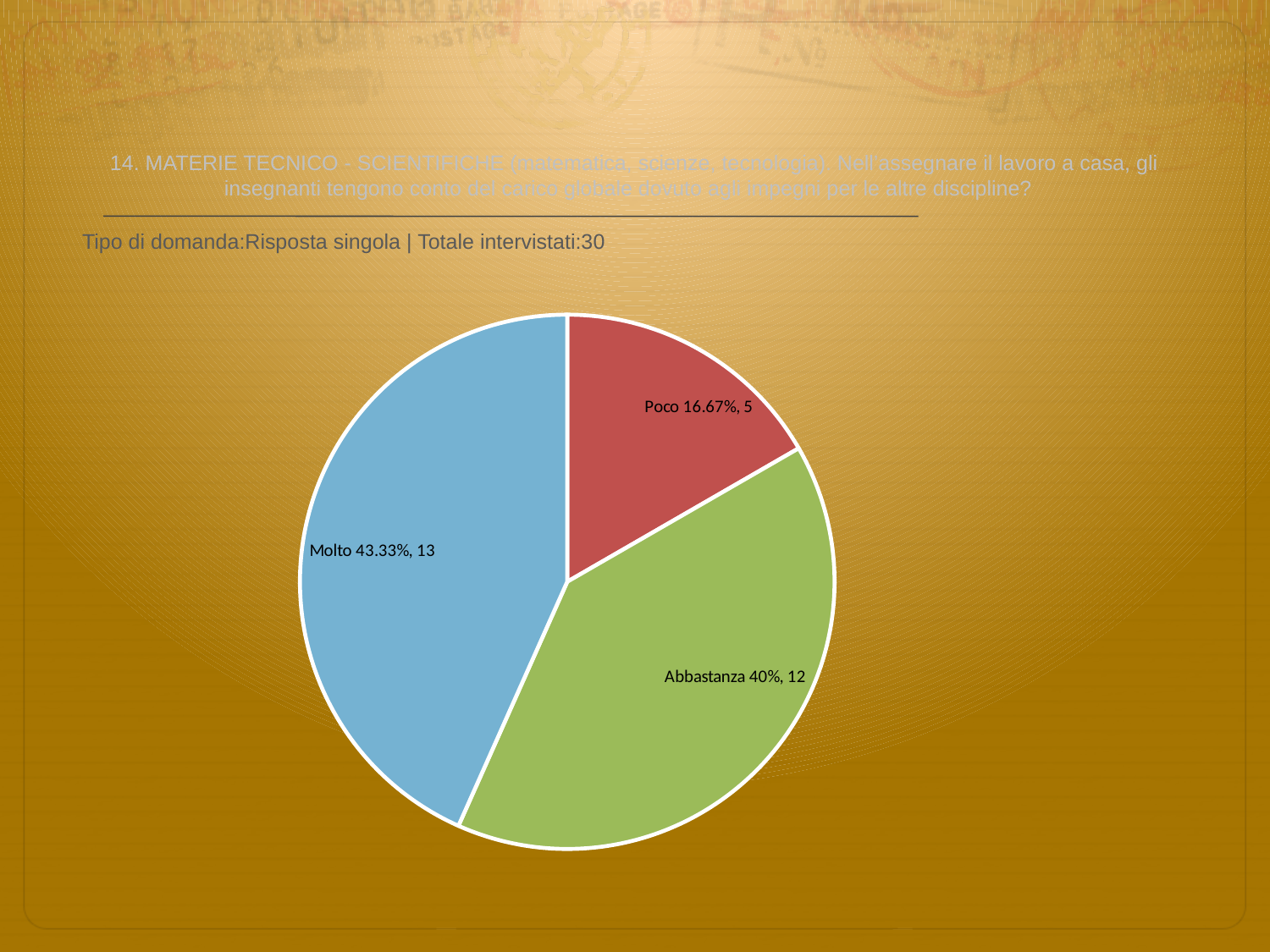
Which category has the smallest slice? Poco How many respondents answered Poco? 5 What colour is the Abbastanza slice? green Which category has the largest slice? Molto What percentage share does the Molto slice have? 43.33% What is the difference in respondent count between Abbastanza and Poco? 7 What percentage share does the Abbastanza slice have? 40% How many respondents answered Molto? 13 Which has more respondents, Molto or Abbastanza? Molto How many slices does the pie chart have? 3 What percentage share does the Poco slice have? 16.67% What kind of chart is shown on the slide? pie chart